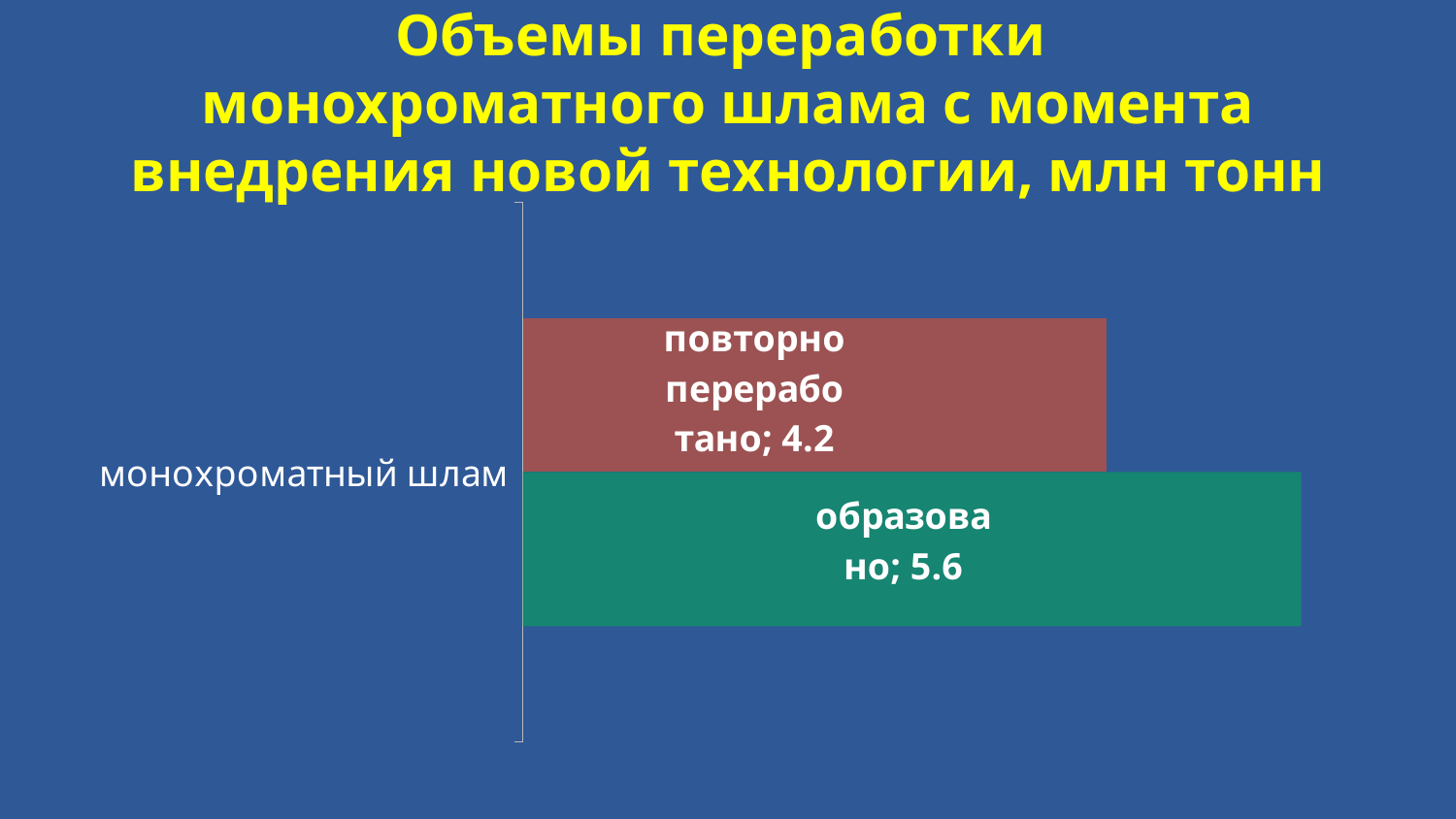
What is the title of the chart? Объемы переработки монохроматного шлама с момента внедрения новой технологии, млн тонн Which series has the highest value on the chart? образовано What colour is the bar for "образовано"? green How many categories are shown on the chart? 1 What is the value for "повторно переработано" for монохроматный шлам? 4.2 What kind of chart is shown on the slide? bar chart Which series has the lowest value on the chart? повторно переработано Which is larger for монохроматный шлам: "образовано" or "повторно переработано"? образовано How many data series are plotted on the chart? 2 What is the name of the category shown on the chart? монохроматный шлам What is the value for "образовано" for монохроматный шлам? 5.6 What is the difference between the "образовано" value and the "повторно переработано" value? 1.4